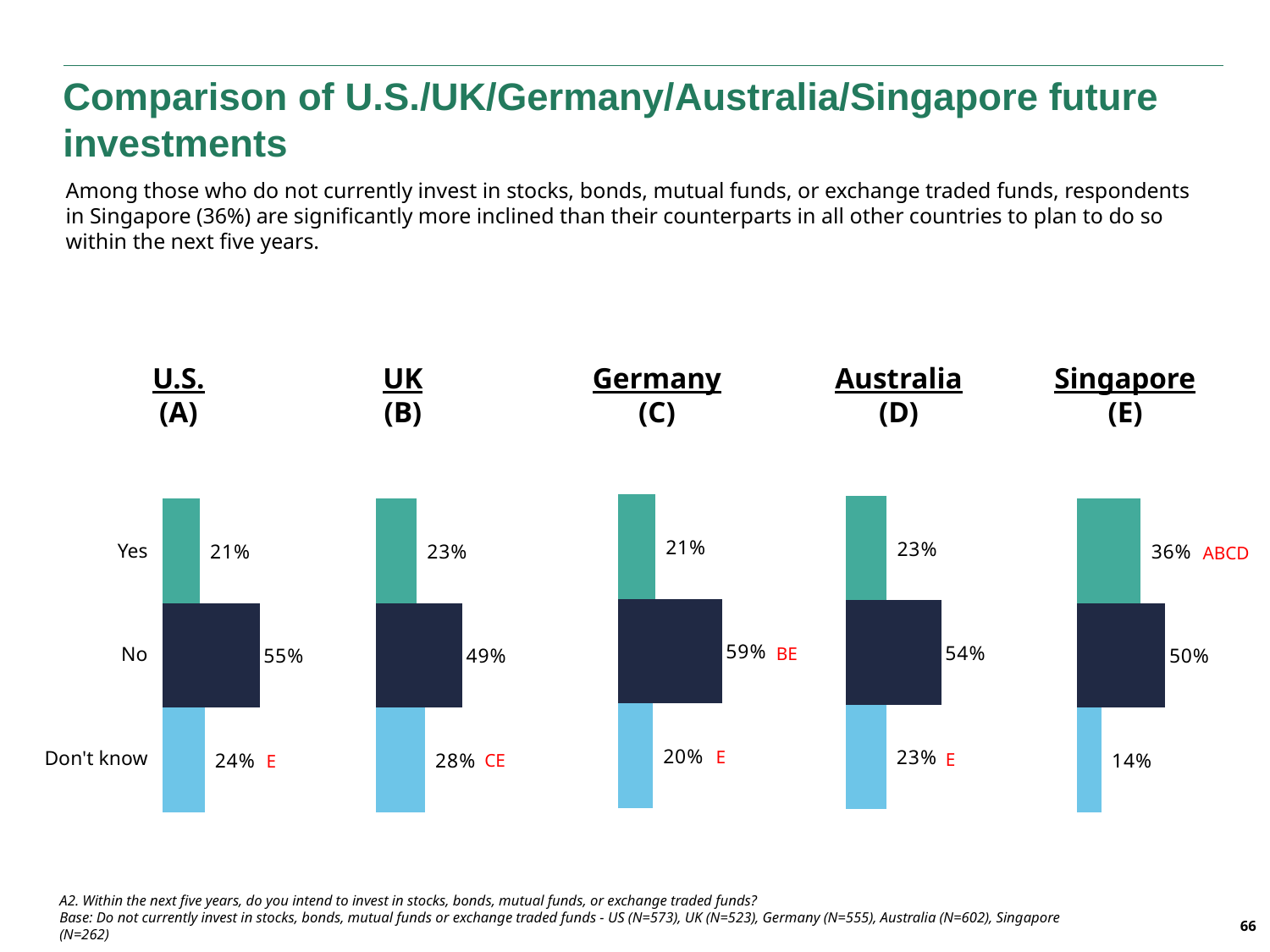
What type of chart is used to show the results for each country? Bar chart In the UK (B) chart, what is the value for "Don't know"? 28% In the Singapore (E) chart, what is the value for "Yes"? 36% How many response categories are shown in each country chart? 3 In the Germany (C) chart, what is the value for "No"? 59% Which is larger: the "No" value for Germany (C) or the "No" value for the UK (B)? Germany (C) Across the five country charts, which country has the lowest "Don't know" value? Singapore What is the difference between the "Don't know" value for the UK (B) and the "Don't know" value for Singapore (E)? 14% In the U.S. (A) chart, what is the value for "No"? 55% What is the difference between the "Yes" value for Singapore (E) and the "Yes" value for the U.S. (A)? 15% Across the five country charts, which country has the highest "Yes" value? Singapore In the Australia (D) chart, which category has the highest value? No